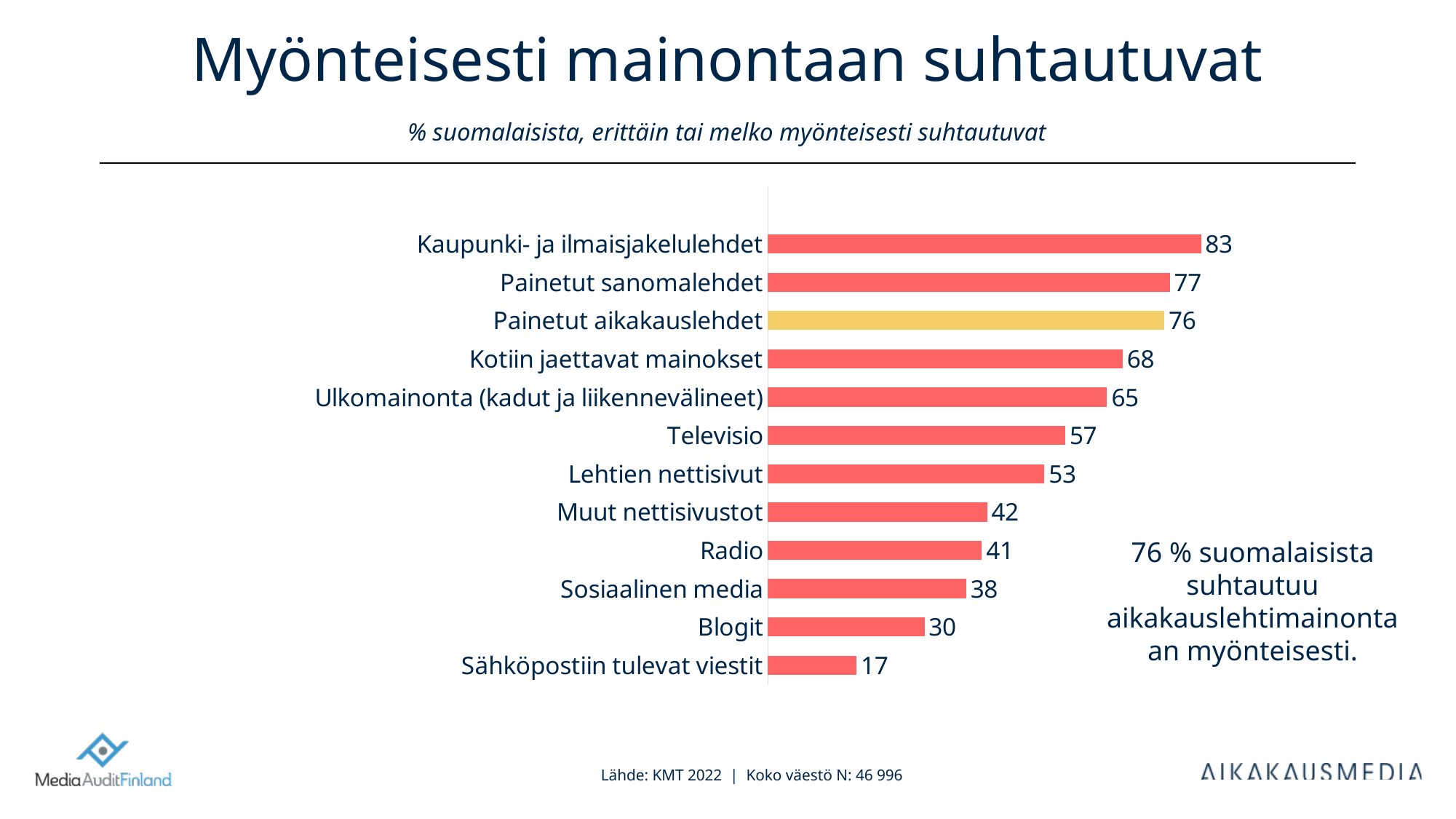
What is the difference between the values for Painetut sanomalehdet and Radio? 36 Which category has the lowest value? Sähköpostiin tulevat viestit Which category has the highest value? Kaupunki- ja ilmaisjakelulehdet How many categories are shown in the chart? 12 Which has a larger value, Lehtien nettisivut or Sosiaalinen media? Lehtien nettisivut Which bar is coloured differently (yellow) from the others? Painetut aikakauslehdet What is the difference between the values for Kotiin jaettavat mainokset and Blogit? 38 What is the value for Televisio? 57 What is the title of the chart on the slide? Myönteisesti mainontaan suhtautuvat What kind of chart is shown on the slide? Bar chart What is the value for Sähköpostiin tulevat viestit? 17 What is the value for Painetut aikakauslehdet? 76